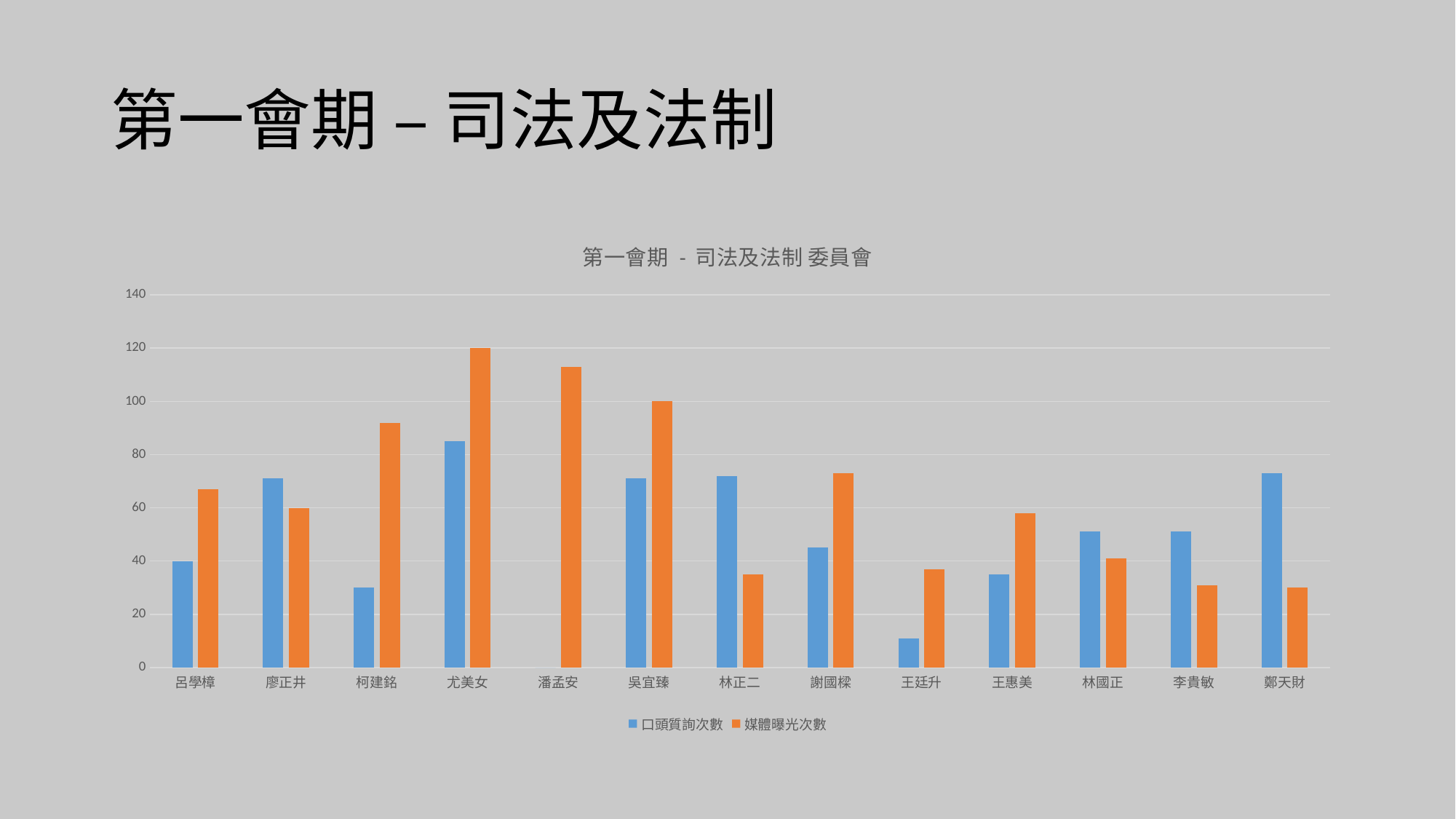
What is the title of the chart? 第一會期 - 司法及法制 委員會 Is the 口頭質詢次數 value for 王廷升 greater or less than 20? less What is the 媒體曝光次數 value for 尤美女? 120 Which legislator has the highest 口頭質詢次數? 尤美女 What is the 媒體曝光次數 value for 吳宜臻? 100 What kind of chart is shown on the slide? bar chart How many legislators (categories) are shown on the x axis? 13 Is the 口頭質詢次數 value for 鄭天財 greater or less than 60? greater For 柯建銘, which is larger: 口頭質詢次數 or 媒體曝光次數? 媒體曝光次數 Is the 媒體曝光次數 value for 潘孟安 greater or less than 100? greater Which legislator has the highest 媒體曝光次數? 尤美女 How many series does the legend list? 2